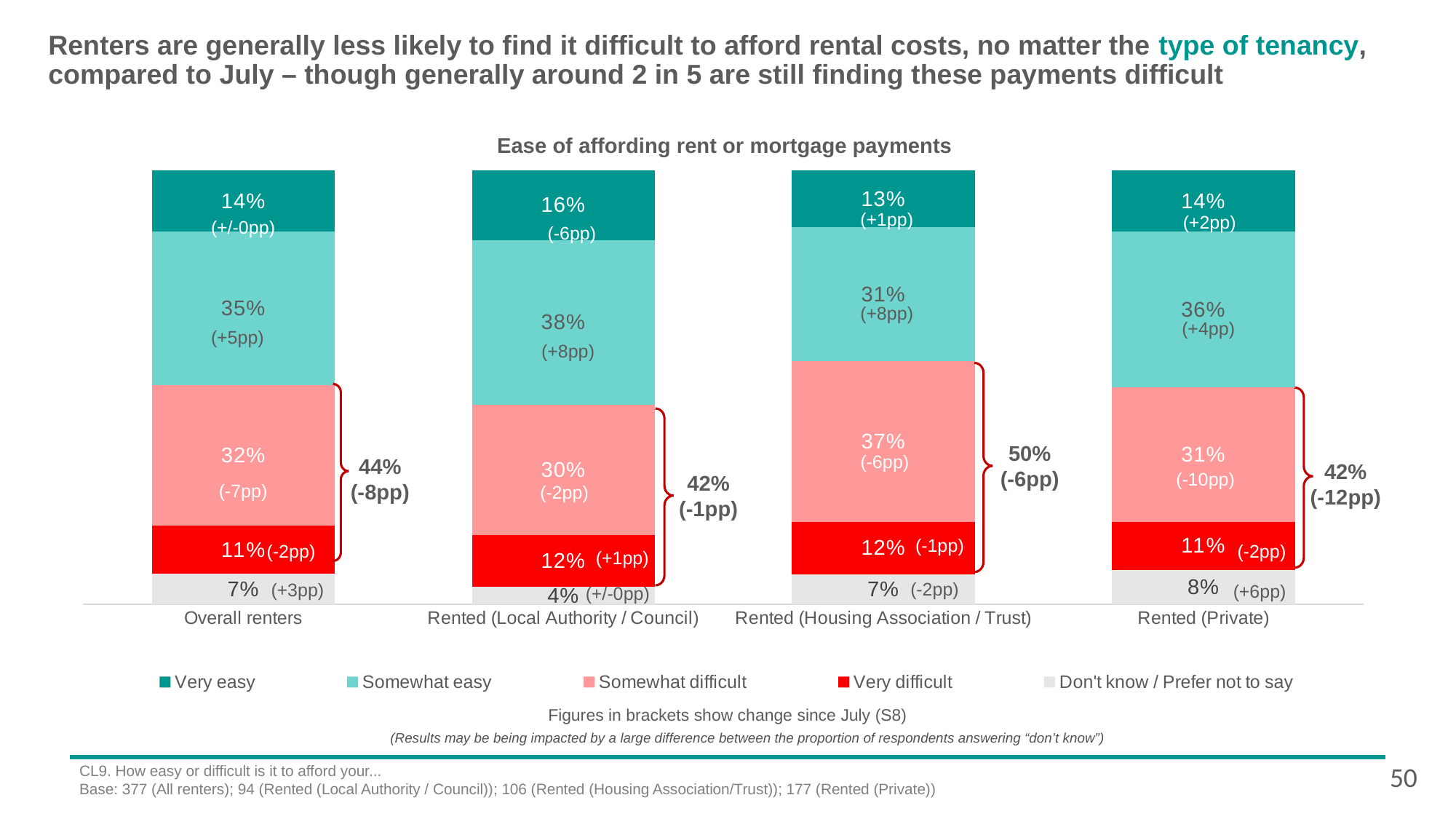
Which tenancy type has the highest Somewhat difficult value? Rented (Housing Association / Trust) What kind of chart is shown on the slide? Stacked bar chart What change since July is shown in brackets for the Somewhat easy segment of Rented (Local Authority / Council)? +8pp How many series does the legend list? 5 What is the difference between the Somewhat easy values for Rented (Local Authority / Council) and Rented (Housing Association / Trust)? 7 percentage points What is the combined Somewhat difficult and Very difficult share shown by the bracket for Rented (Housing Association / Trust)? 50% Which is larger: the Very easy value for Rented (Local Authority / Council) or for Rented (Housing Association / Trust)? Rented (Local Authority / Council) What is the Very easy value for Rented (Local Authority / Council)? 16% How many tenancy categories are shown on the x axis? 4 Which tenancy type has the lowest Don't know / Prefer not to say value? Rented (Local Authority / Council) What percentage of Overall renters say it is Somewhat difficult to afford rent or mortgage payments? 32% What is the Don't know / Prefer not to say value for Rented (Private)? 8%